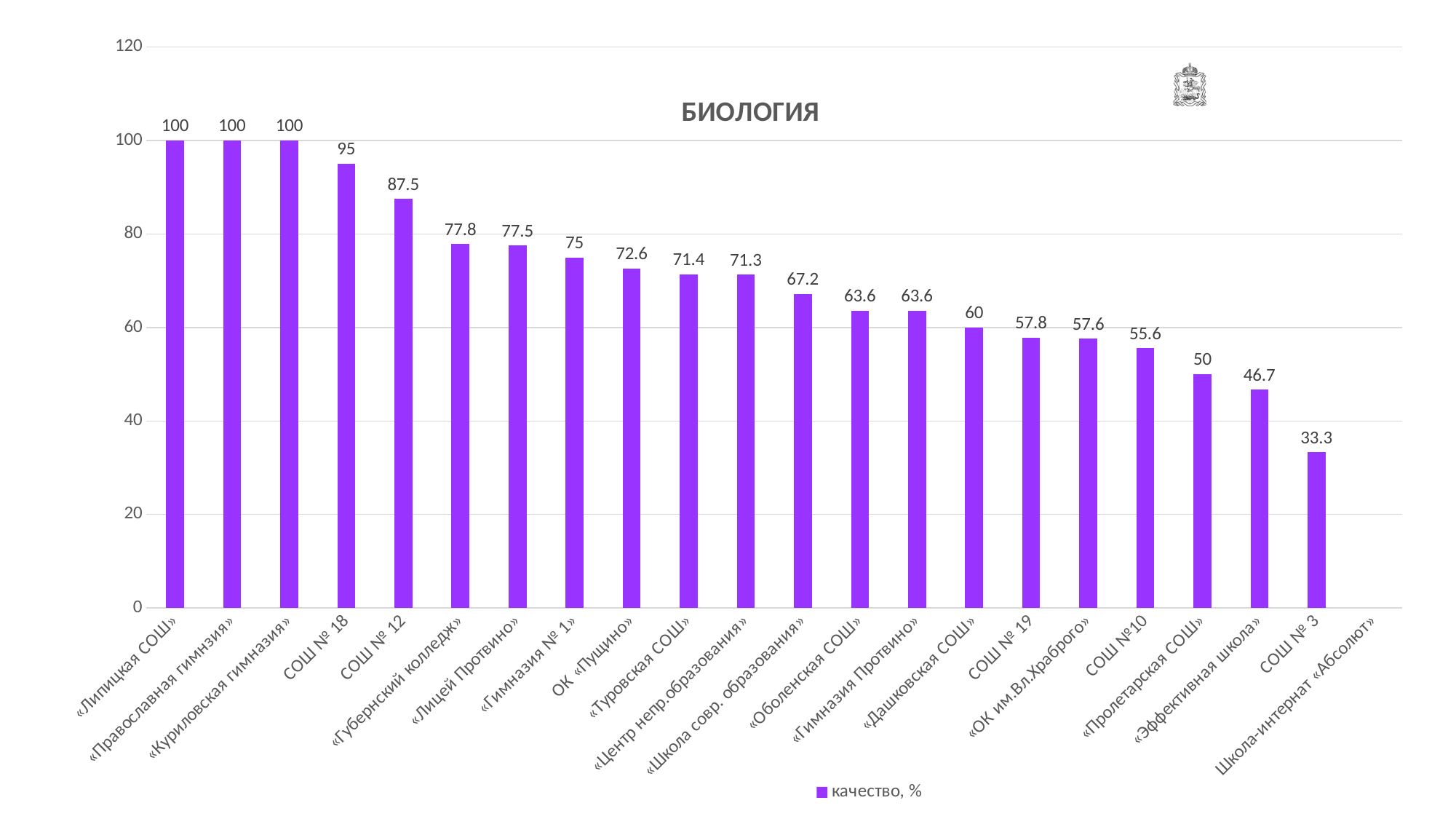
Do the values generally rise or fall from left to right along the x axis? fall Which category has the lowest bar on the chart? СОШ № 3 What is the value for «Губернский колледж»? 77.8 What is the title of the chart? БИОЛОГИЯ Is the value for «Оболенская СОШ» greater or less than 80? less What kind of chart is shown on the slide? bar chart What is the difference between the values for СОШ № 18 and СОШ № 12? 7.5 What is the value for «Дашковская СОШ»? 60 What is the difference between the values for «Пролетарская СОШ» and СОШ № 3? 16.7 Which is larger, the value for ОК «Пущино» or the value for «Школа совр. образования»? ОК «Пущино» What is the value for СОШ № 12? 87.5 What is the value for «Эффективная школа»? 46.7